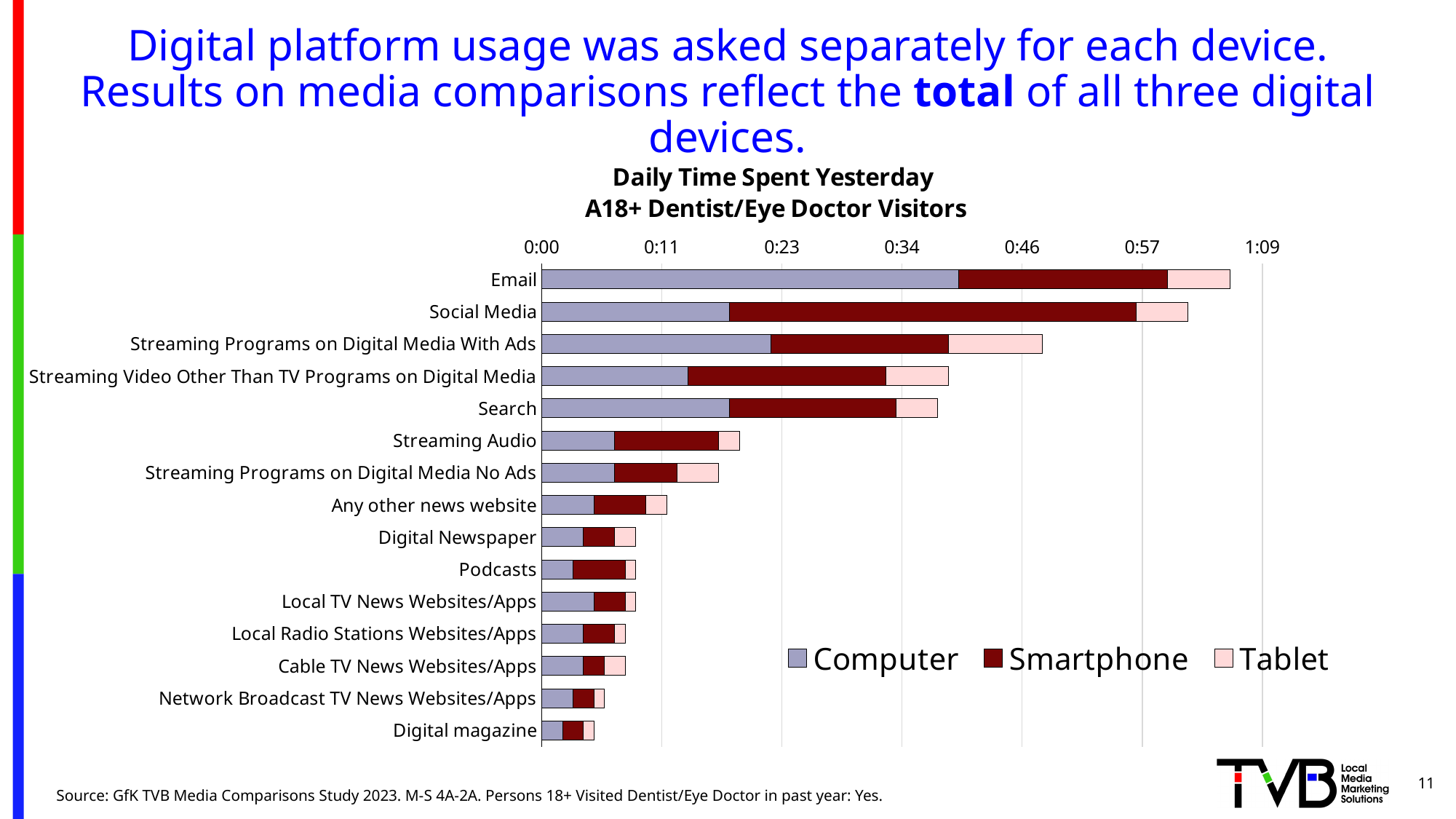
How many categories (digital platforms) are plotted in the chart? 15 Is the total daily time for Email greater or less than 0:57? greater What kind of chart is shown on the slide? Stacked bar chart What is the title of the chart? Daily Time Spent Yesterday A18+ Dentist/Eye Doctor Visitors Is the total daily time for Streaming Video Other Than TV Programs on Digital Media greater or less than 0:46? less Which has a longer total bar, Email or Social Media? Email Which has a longer total bar, Streaming Audio or Podcasts? Streaming Audio Is the total daily time for Search greater or less than 0:34? greater Which category has the longest total bar? Email Which series is shown in dark red in the chart? Smartphone How many series does the legend list? 3